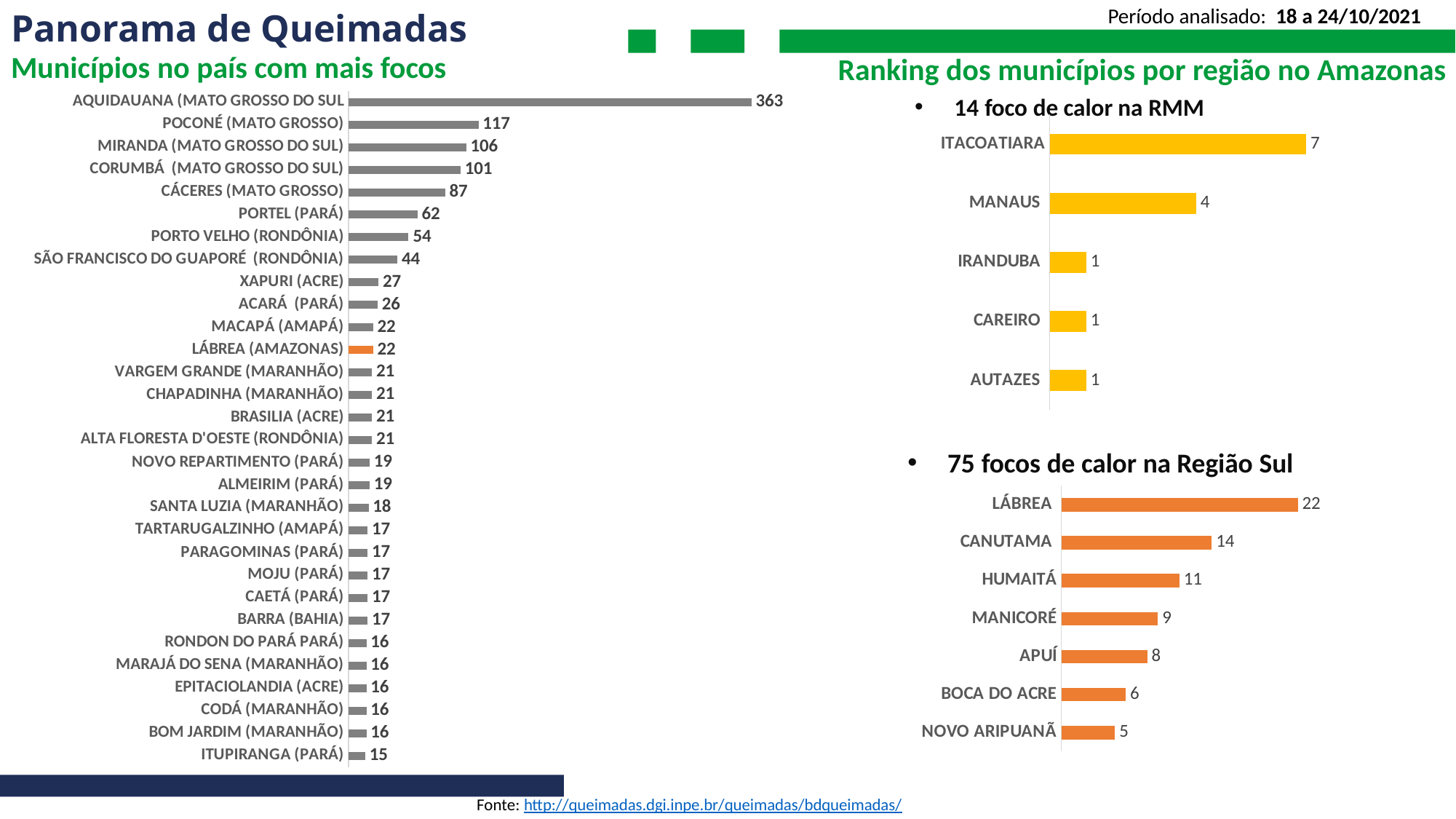
In the 'Municípios no país com mais focos' chart, which municipality has the lowest value? ITUPIRANGA (PARÁ) In the '14 foco de calor na RMM' chart, which municipality has the highest value? ITACOATIARA In the '75 focos de calor na Região Sul' chart, what is the difference between LÁBREA and CANUTAMA? 8 In the 'Municípios no país com mais focos' chart, which is larger, PORTEL (PARÁ) or PORTO VELHO (RONDÔNIA)? PORTEL (PARÁ) In the 'Municípios no país com mais focos' chart, how many municipalities are plotted? 30 In the 'Municípios no país com mais focos' chart, which bar is coloured orange instead of grey? LÁBREA (AMAZONAS) In the '75 focos de calor na Região Sul' chart, what is the value for HUMAITÁ? 11 In the 'Municípios no país com mais focos' chart, what is the difference between POCONÉ (MATO GROSSO) and MIRANDA (MATO GROSSO DO SUL)? 11 What kind of chart is the '75 focos de calor na Região Sul' chart? Bar chart In the '14 foco de calor na RMM' chart, what is the value for MANAUS? 4 In the '14 foco de calor na RMM' chart, how many municipalities are plotted? 5 In the 'Municípios no país com mais focos' chart, what is the value for AQUIDAUANA (MATO GROSSO DO SUL)? 363